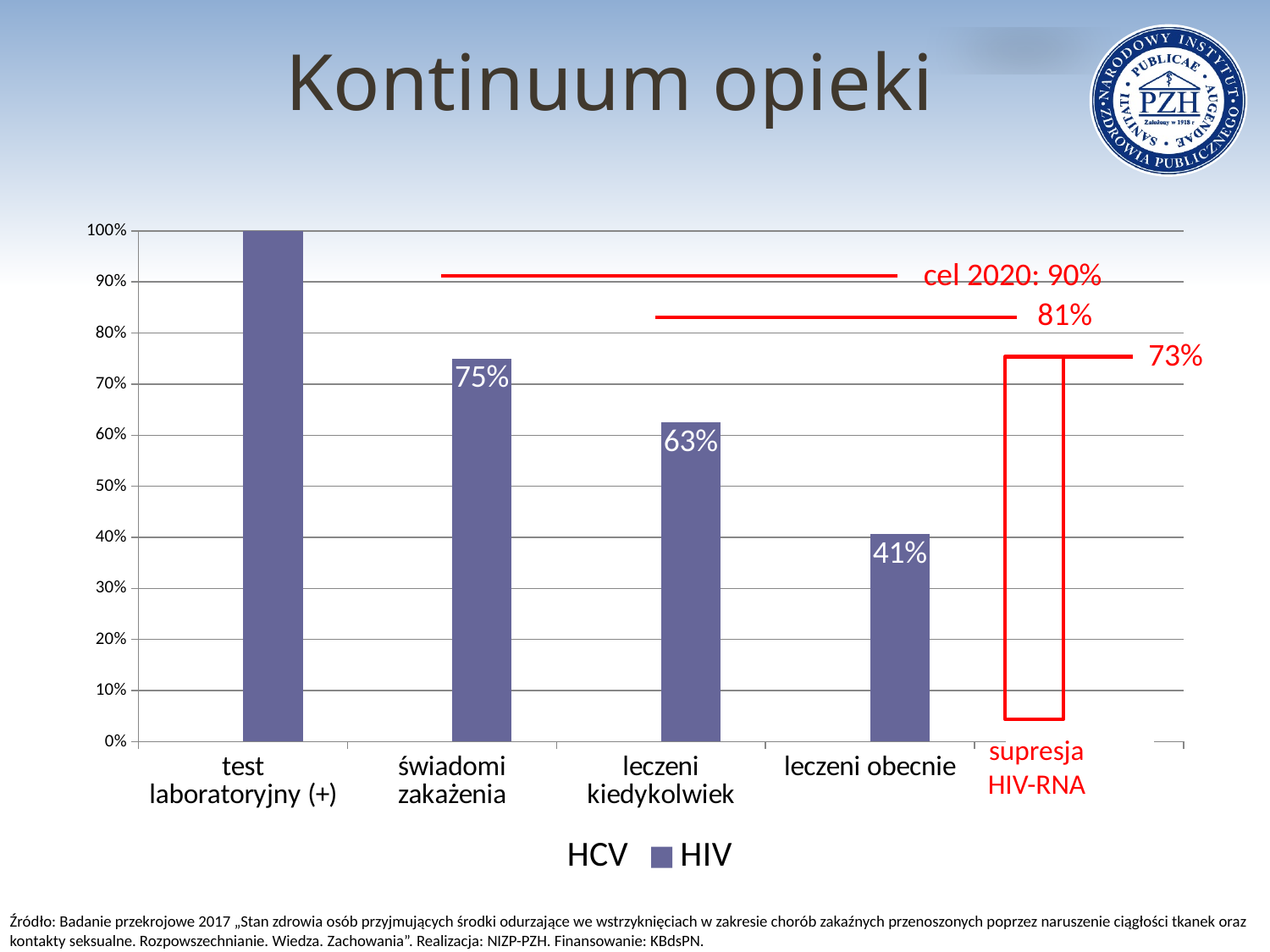
How many series does the legend list? 2 What is the value for świadomi zakażenia? 75% What is the value for leczeni kiedykolwiek? 63% What is the value for leczeni obecnie? 41% What value does the bar for test laboratoryjny (+) reach? 100% Is the value for leczeni obecnie greater or less than 50%? less Which of the blue bars is the lowest? leczeni obecnie Do the blue bars rise or fall from left to right across the categories? fall Which category has the highest bar? test laboratoryjny (+) Which is larger, the value for leczeni kiedykolwiek or for leczeni obecnie? leczeni kiedykolwiek What kind of chart is shown on the slide? bar chart What is the difference between the values for świadomi zakażenia and leczeni kiedykolwiek? 12 percentage points